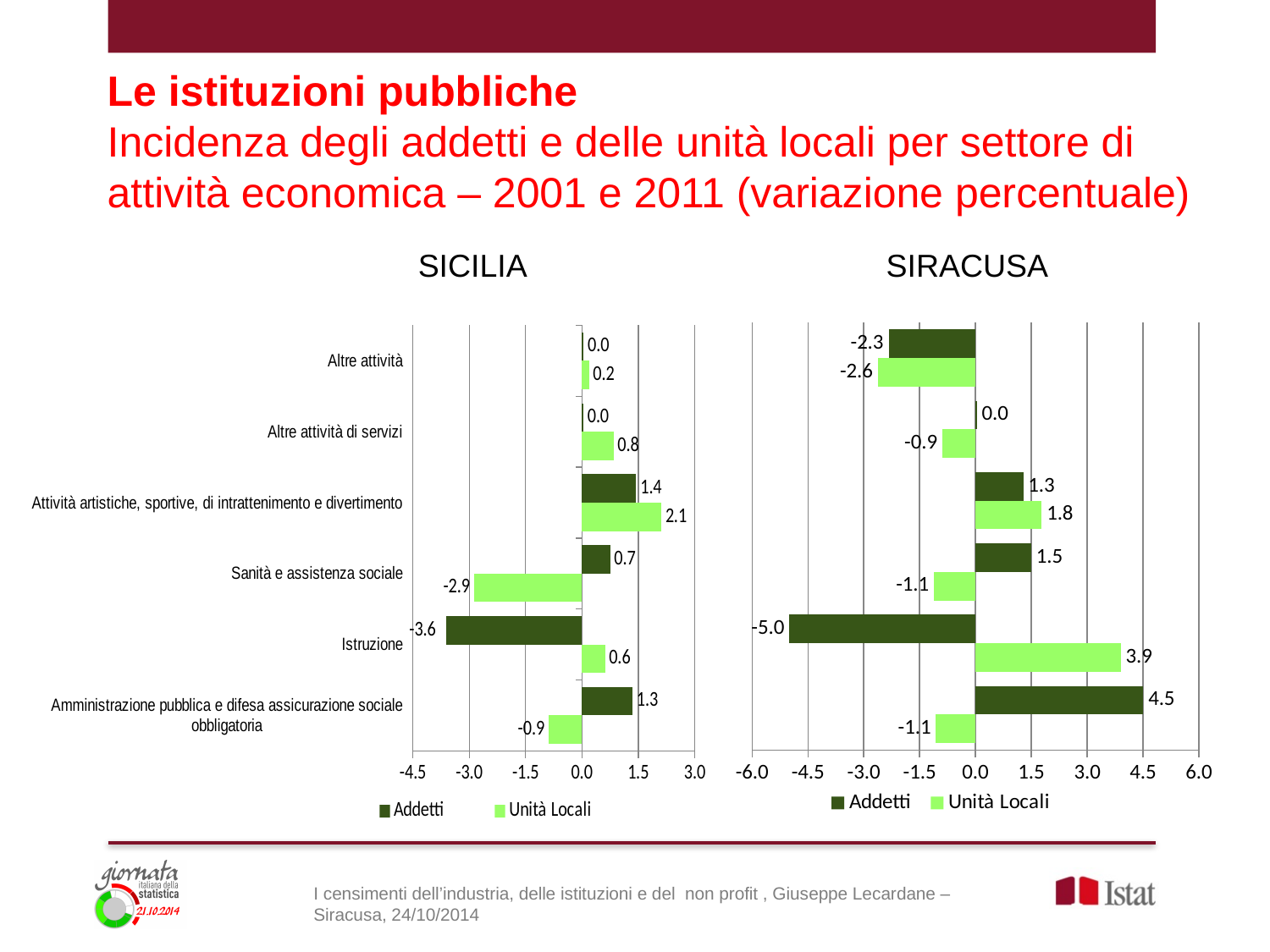
In the SICILIA chart, which category has the highest Unità Locali value? Attività artistiche, sportive, di intrattenimento e divertimento How many categories are shown in the SIRACUSA chart? 6 In the SIRACUSA chart, which category has the lowest Addetti value? Istruzione In the SIRACUSA chart, what is the Unità Locali value for Istruzione? 3.9 In the SICILIA chart, what is the Unità Locali value for Sanità e assistenza sociale? -2.9 In the SICILIA chart, what is the Addetti value for Istruzione? -3.6 In the SICILIA chart, which is larger for Attività artistiche, sportive, di intrattenimento e divertimento: Addetti or Unità Locali? Unità Locali In the SIRACUSA chart, what is the Addetti value for Altre attività? -2.3 In the SIRACUSA chart, which category has the highest Addetti value? Amministrazione pubblica e difesa assicurazione sociale obbligatoria What type of chart is the SIRACUSA chart? Bar chart How many series does the legend of the SICILIA chart list? 2 In the SIRACUSA chart, what is the difference between the Addetti value for Amministrazione pubblica e difesa assicurazione sociale obbligatoria (4.5) and the Addetti value for Istruzione (-5.0)? 9.5